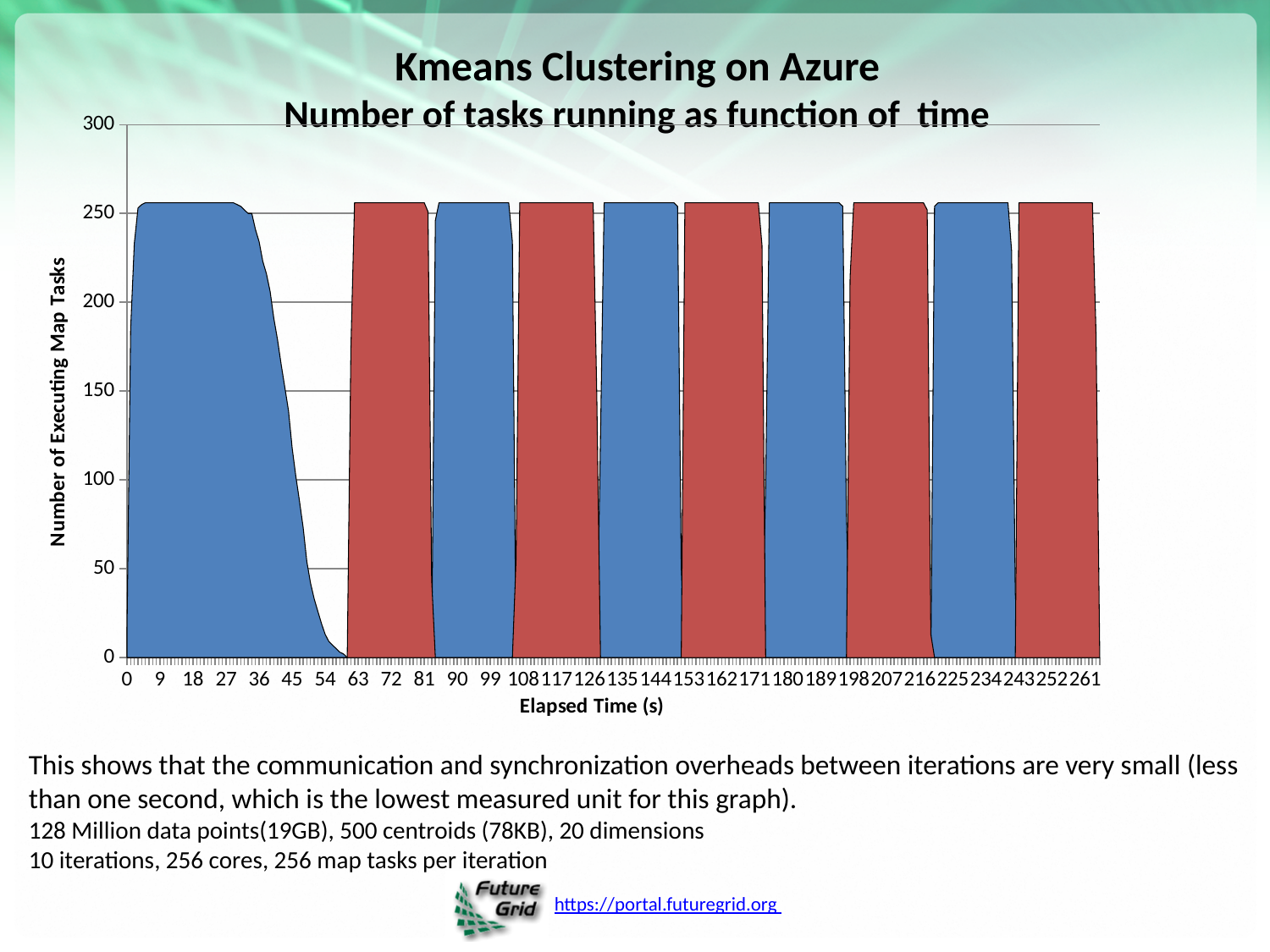
What is the highest value shown on the y axis? 300 What is the last tick label on the x axis? 261 Is the number of executing map tasks at 54 s greater or less than 50? less Is the number of executing map tasks at 99 s greater or less than 200? greater What kind of chart is shown on the slide? area chart Is the number of executing map tasks at 18 s greater or less than 200? greater What is the title of the chart? Kmeans Clustering on Azure Number of tasks running as function of time How many separate filled blocks (iterations) are plotted along the x axis? 10 Between 36 s and 54 s, does the number of executing map tasks rise or fall? fall What is the label of the y axis? Number of Executing Map Tasks